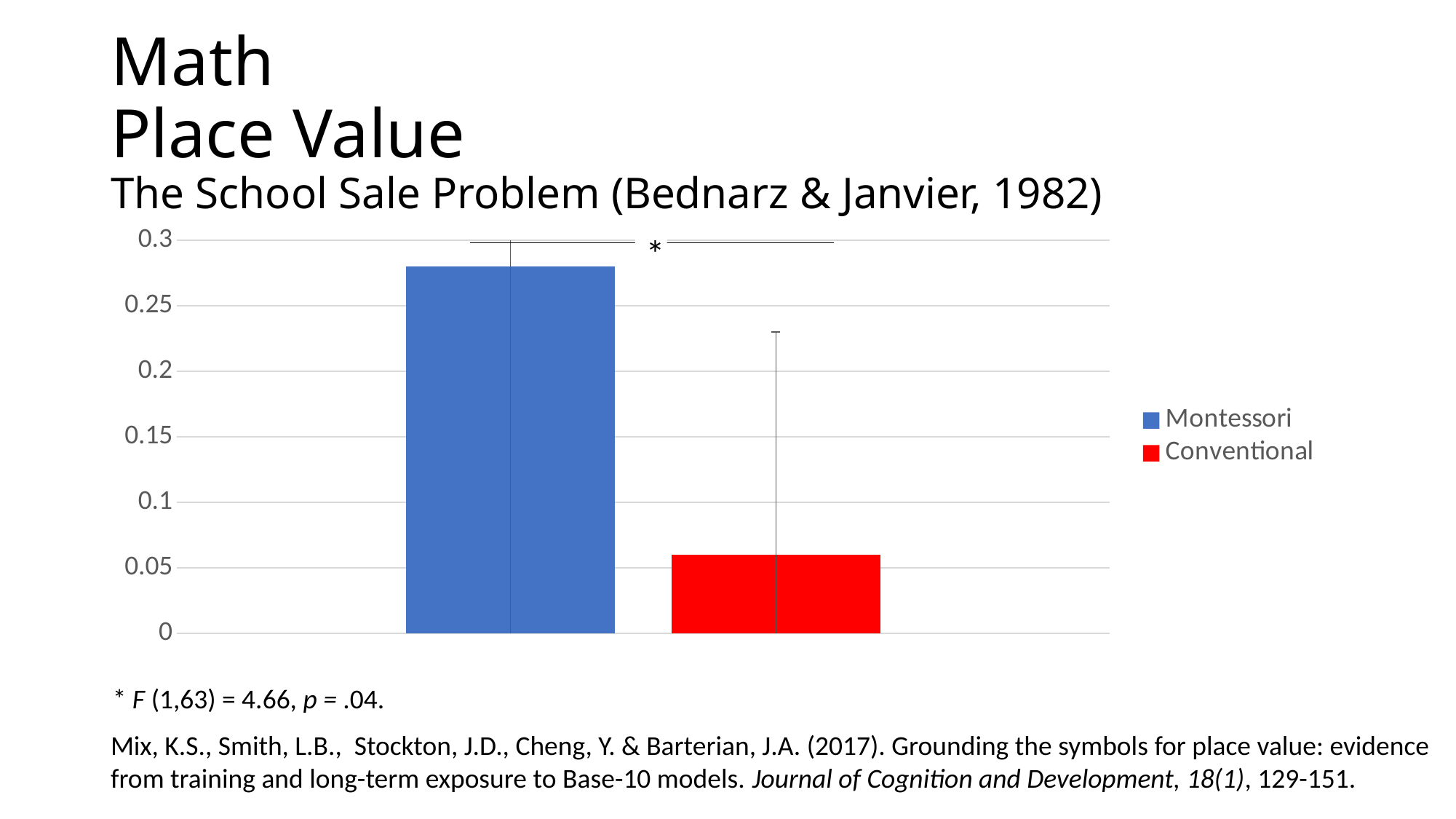
Is the value for Conventional greater or less than 0.1? less Is the value for Conventional greater or less than 0.15? less What colour is the Conventional bar in the chart? red Which group has the lowest bar in the chart? Conventional What is the highest value shown on the chart's vertical axis? 0.3 Is the value for Montessori greater or less than 0.3? less Which bar is taller, Montessori or Conventional? Montessori How many series does the legend list? 2 How many bars are plotted in the chart? 2 What kind of chart is shown on the slide? bar chart Which group has the highest bar in the chart? Montessori